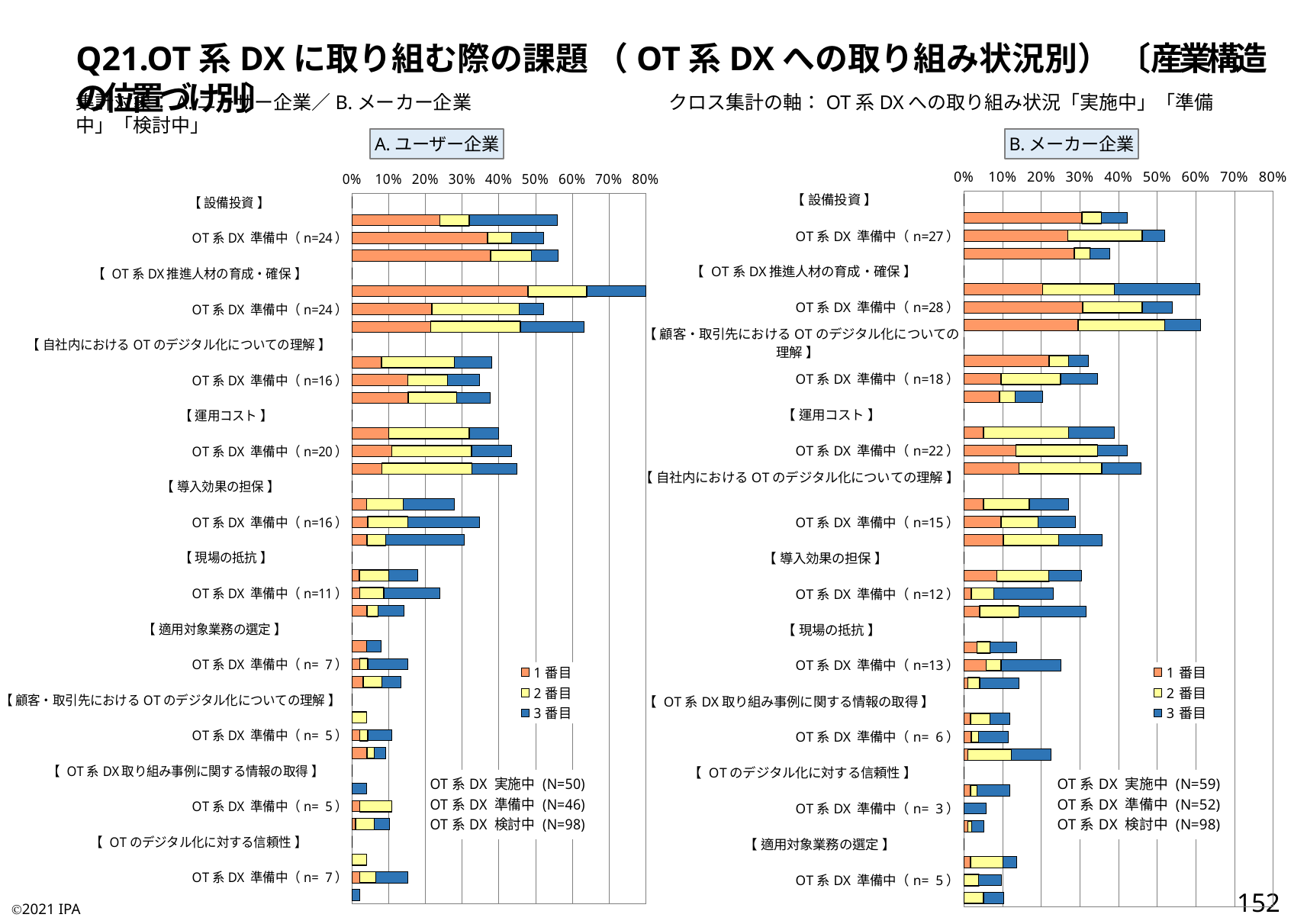
In the B. メーカー企業 chart, is the total bar for OT系DX 実施中 under 【OT系DX推進人材の育成・確保】 greater or less than 50%? greater In the B. メーカー企業 chart, under 【現場の抵抗】, which total bar is longer: OT系DX 実施中 or OT系DX 準備中 (n=13)? OT系DX 準備中 (n=13) What are the legend entries of the A. ユーザー企業 chart? 1番目, 2番目, 3番目 What is the maximum value shown on the x axis of the B. メーカー企業 chart? 80% How many issue categories (bracketed headings) are shown on the A. ユーザー企業 chart? 10 In the A. ユーザー企業 chart, under 【OT系DX推進人材の育成・確保】, which total bar is longer: OT系DX 実施中 or OT系DX 準備中 (n=24)? OT系DX 実施中 In the B. メーカー企業 chart, is the total bar for OT系DX 検討中 under 【運用コスト】 greater or less than 40%? greater What kind of chart is the A. ユーザー企業 chart? Stacked horizontal bar chart How many series does the legend of the B. メーカー企業 chart list? 3 In the A. ユーザー企業 chart, is the total bar for OT系DX 実施中 under 【設備投資】 greater or less than 50%? greater